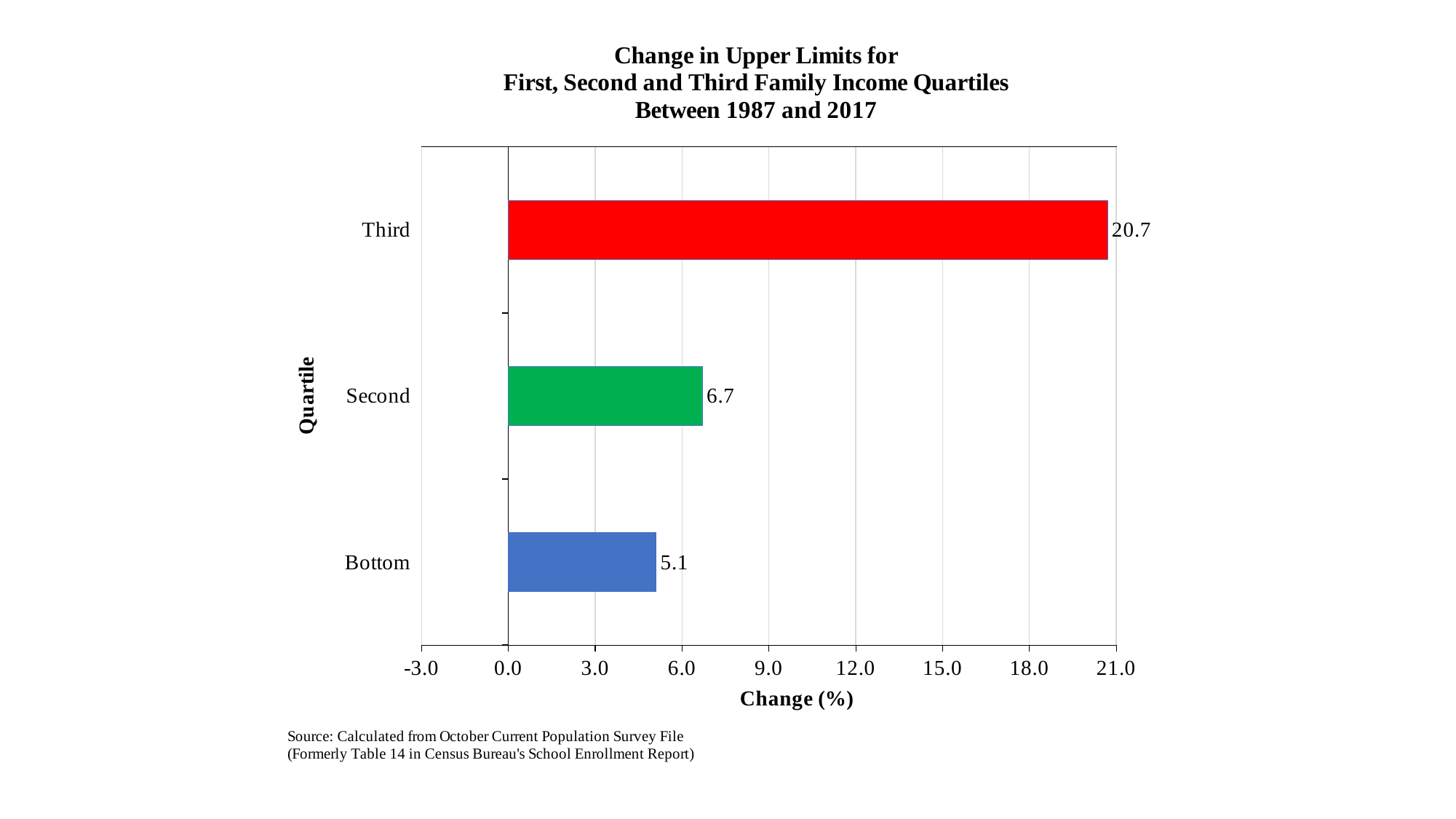
How many quartiles are shown in the chart? 3 What is the difference between the change for the Second quartile and the Bottom quartile? 1.6 Which quartile has the highest change in upper limit? Third Which has a larger change in upper limit, the Second quartile or the Bottom quartile? Second Which quartile has the lowest change in upper limit? Bottom Is the value for the Third quartile greater or less than 18.0? greater What is the change in the upper limit for the Second quartile? 6.7 What is the label of the horizontal axis? Change (%) What is the change in the upper limit for the Third quartile? 20.7 What is the change in the upper limit for the Bottom quartile? 5.1 What is the difference between the change for the Third quartile and the Second quartile? 14.0 What kind of chart is shown on the slide? bar chart